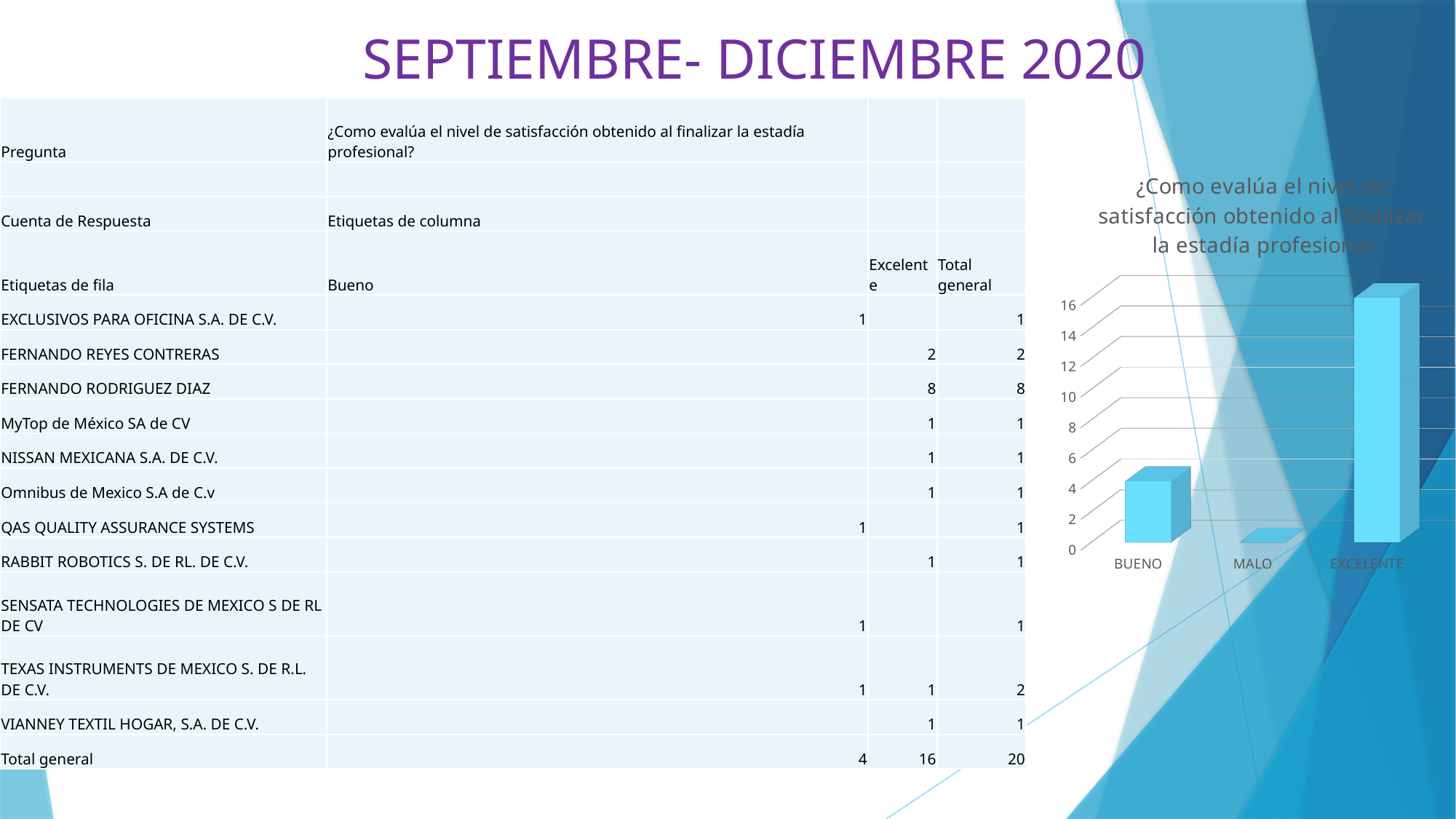
Which is larger in the chart, the value for BUENO or the value for MALO? BUENO What is the title of the chart? ¿Como evalúa el nivel de satisfacción obtenido al finalizar la estadía profesional Which category has the lowest bar in the chart? MALO Is the value for BUENO greater or less than 8? less Is the value for MALO greater or less than 2? less What kind of chart is shown on the slide? bar chart Which category has the highest bar in the chart? EXCELENTE Is the value for EXCELENTE greater or less than 14? greater What is the highest tick value shown on the vertical axis of the chart? 16 Which is larger in the chart, the value for BUENO or the value for EXCELENTE? EXCELENTE How many categories are shown on the x axis of the chart? 3